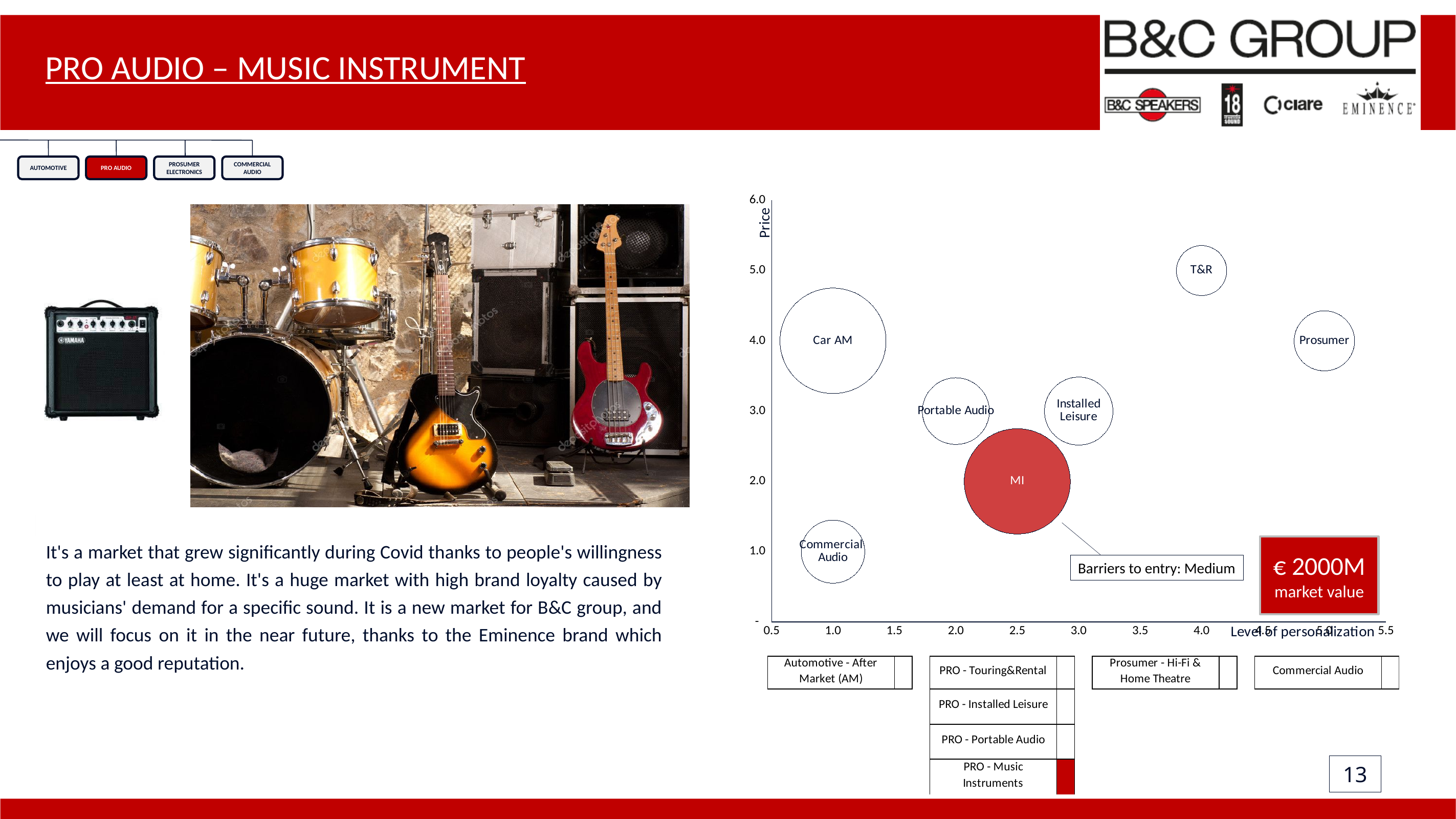
Is the Level of personalization for Prosumer greater or less than 4.0? greater Which bubble on the chart is filled in red? MI Which bubble has the highest Price value on the chart? T&R Is the Price value for T&R greater or less than 4.0? greater Which has a higher Price value, Car AM or MI? Car AM What is the label of the vertical axis of the chart? Price Which has a higher Level of personalization, Installed Leisure or Portable Audio? Installed Leisure How many bubbles are plotted on the chart? 7 Is the Price value for Commercial Audio greater or less than 2.0? less What kind of chart is shown on the right of the slide? Bubble chart Which bubble has the highest Level of personalization on the chart? Prosumer Which bubble has the lowest Price value on the chart? Commercial Audio